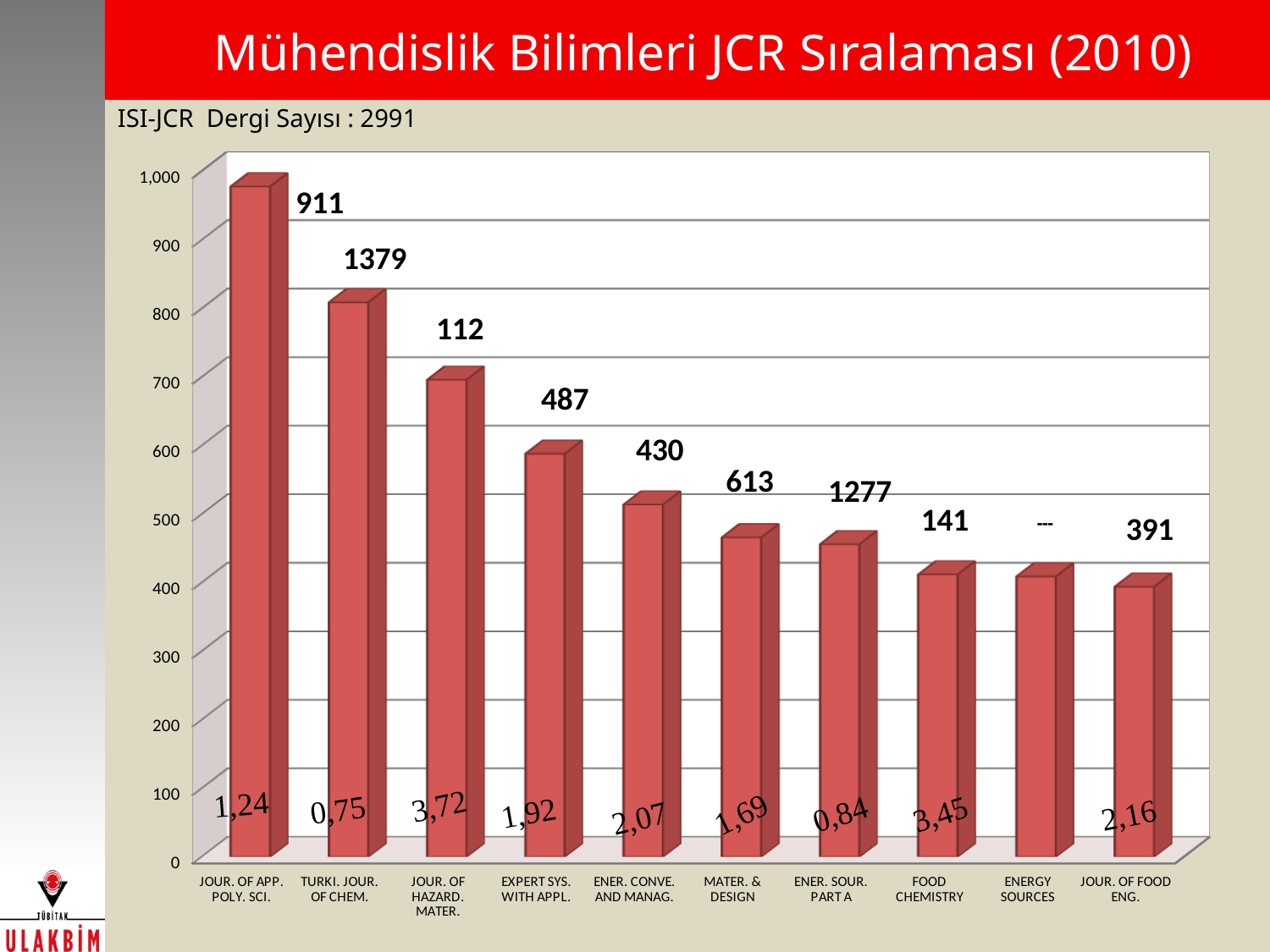
How many journal categories are shown along the x axis? 10 Is the bar for JOUR. OF FOOD ENG. greater or less than 500? less Is the bar for ENER. CONVE. AND MANAG. greater or less than 400? greater What is the title of the slide containing the chart? Mühendislik Bilimleri JCR Sıralaması (2010) Is the bar for TURKI. JOUR. OF CHEM. greater or less than 700? greater Which bar is taller, EXPERT SYS. WITH APPL. or MATER. & DESIGN? EXPERT SYS. WITH APPL. Which category has the tallest bar? JOUR. OF APP. POLY. SCI. What number is printed above the bar for FOOD CHEMISTRY? 141 Which category has the shortest bar? JOUR. OF FOOD ENG. Do the bar heights rise or fall from left to right along the x axis? fall What kind of chart is shown on the slide? bar chart